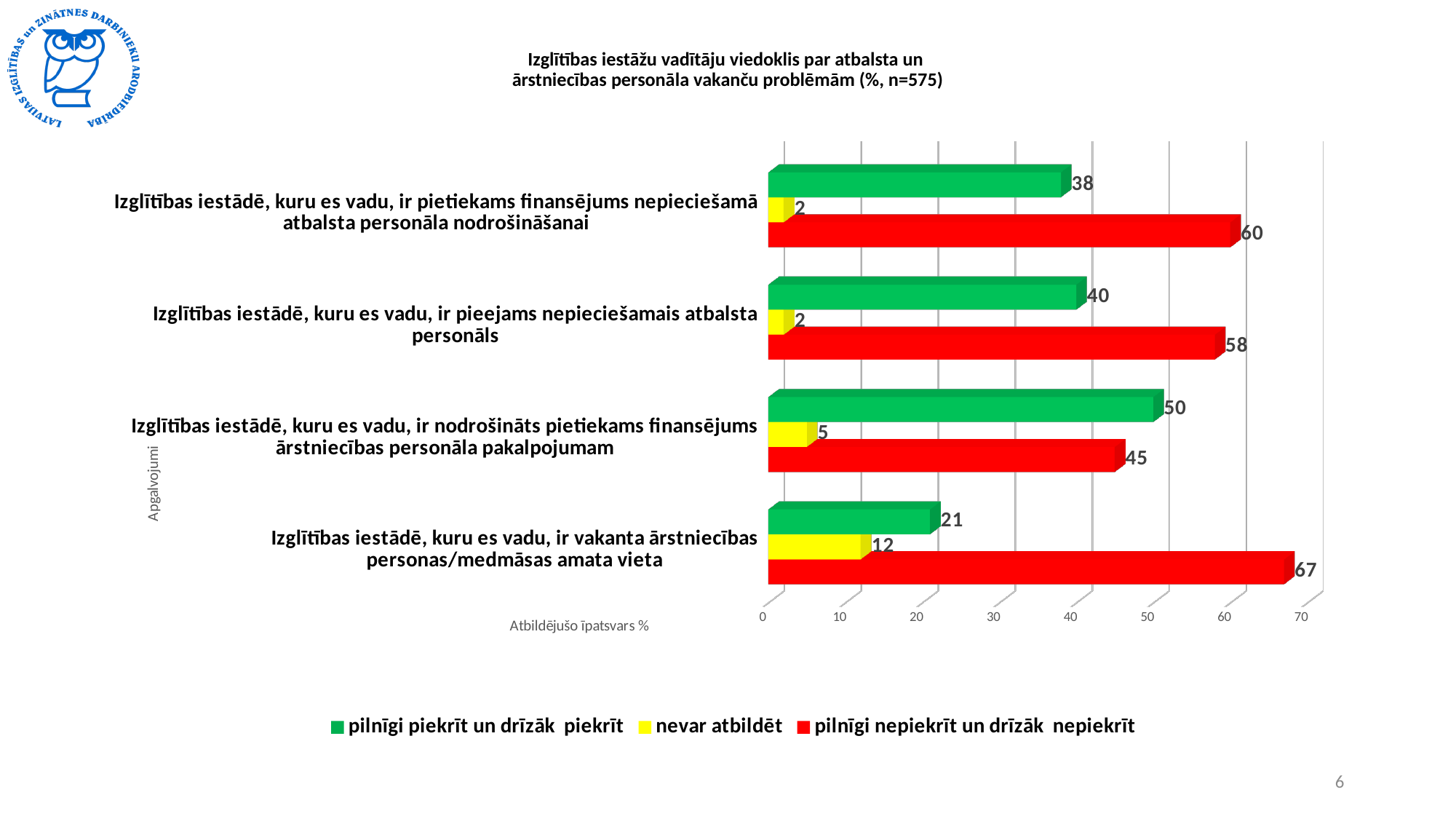
What is the value of "pilnīgi piekrīt un drīzāk piekrīt" for the statement "Izglītības iestādē, kuru es vadu, ir nodrošināts pietiekams finansējums ārstniecības personāla pakalpojumam"? 50 How many series does the legend list? 3 Which colour represents the series "nevar atbildēt" in the legend? yellow Which statement has the highest value for "nevar atbildēt"? Izglītības iestādē, kuru es vadu, ir vakanta ārstniecības personas/medmāsas amata vieta What is the difference between the "pilnīgi nepiekrīt un drīzāk nepiekrīt" value and the "pilnīgi piekrīt un drīzāk piekrīt" value for the statement "Izglītības iestādē, kuru es vadu, ir pietiekams finansējums nepieciešamā atbalsta personāla nodrošināšanai"? 22 How many statements (categories) are plotted on the chart? 4 Which statement has the highest value for "pilnīgi nepiekrīt un drīzāk nepiekrīt"? Izglītības iestādē, kuru es vadu, ir vakanta ārstniecības personas/medmāsas amata vieta For the statement "Izglītības iestādē, kuru es vadu, ir nodrošināts pietiekams finansējums ārstniecības personāla pakalpojumam", which is larger: "pilnīgi piekrīt un drīzāk piekrīt" or "pilnīgi nepiekrīt un drīzāk nepiekrīt"? pilnīgi piekrīt un drīzāk piekrīt What type of chart is shown on the slide? bar chart What is the value of "pilnīgi nepiekrīt un drīzāk nepiekrīt" for the statement "Izglītības iestādē, kuru es vadu, ir vakanta ārstniecības personas/medmāsas amata vieta"? 67 Which statement has the lowest value for "pilnīgi piekrīt un drīzāk piekrīt"? Izglītības iestādē, kuru es vadu, ir vakanta ārstniecības personas/medmāsas amata vieta What is the value of "nevar atbildēt" for the statement "Izglītības iestādē, kuru es vadu, ir pieejams nepieciešamais atbalsta personāls"? 2